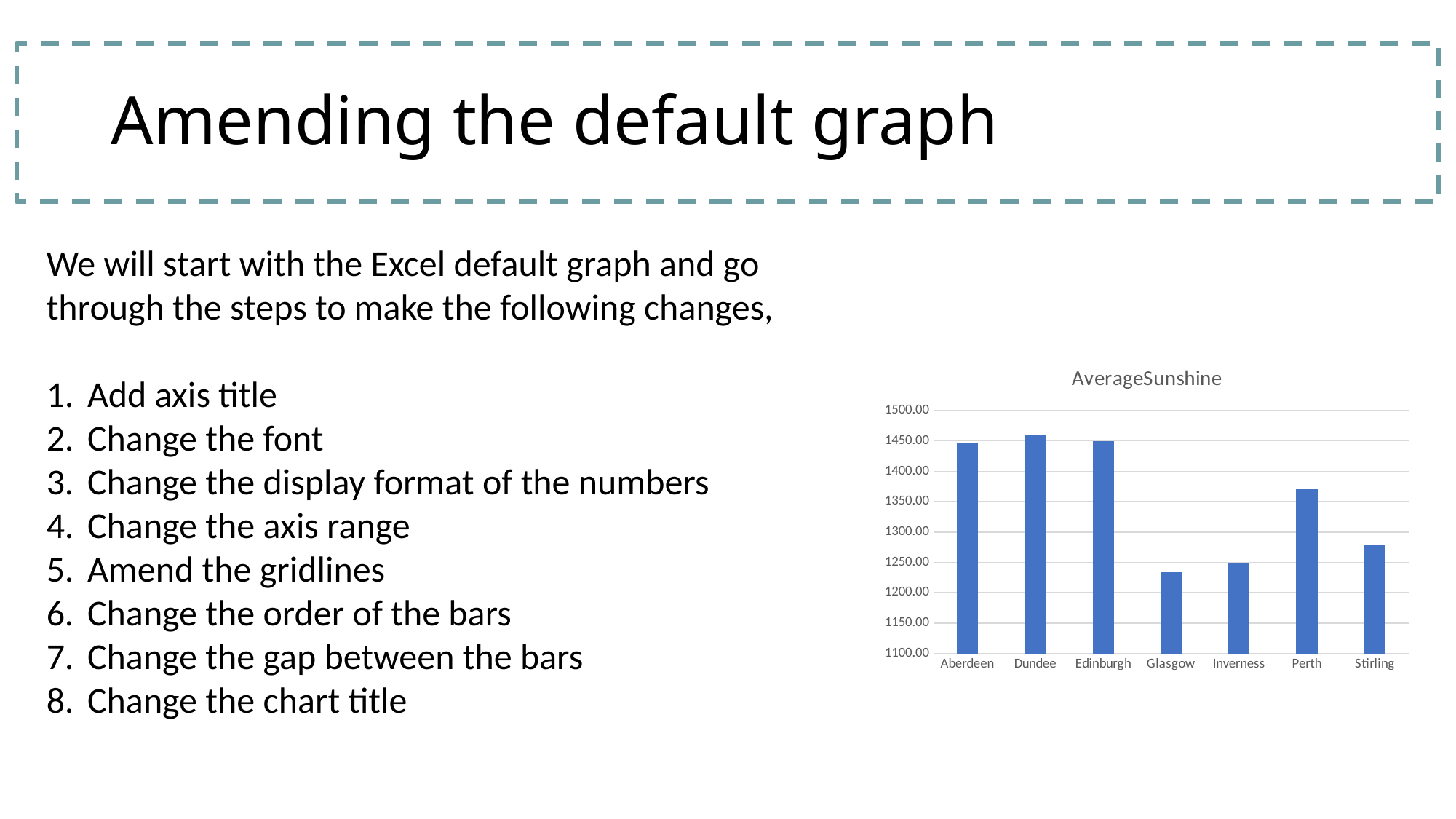
Which has the larger value, Inverness or Stirling? Stirling What is the title of the chart? AverageSunshine How many cities are shown on the x axis of the chart? 7 Is the value for Stirling greater or less than 1250.00? greater Is the value for Aberdeen greater or less than 1400.00? greater Is the value for Perth greater or less than 1350.00? greater What kind of chart is shown on the slide? Bar chart Which has the larger value, Perth or Stirling? Perth What is the lowest value shown on the vertical axis of the chart? 1100.00 Which has the larger value, Aberdeen or Glasgow? Aberdeen Which city has the lowest value in the chart? Glasgow